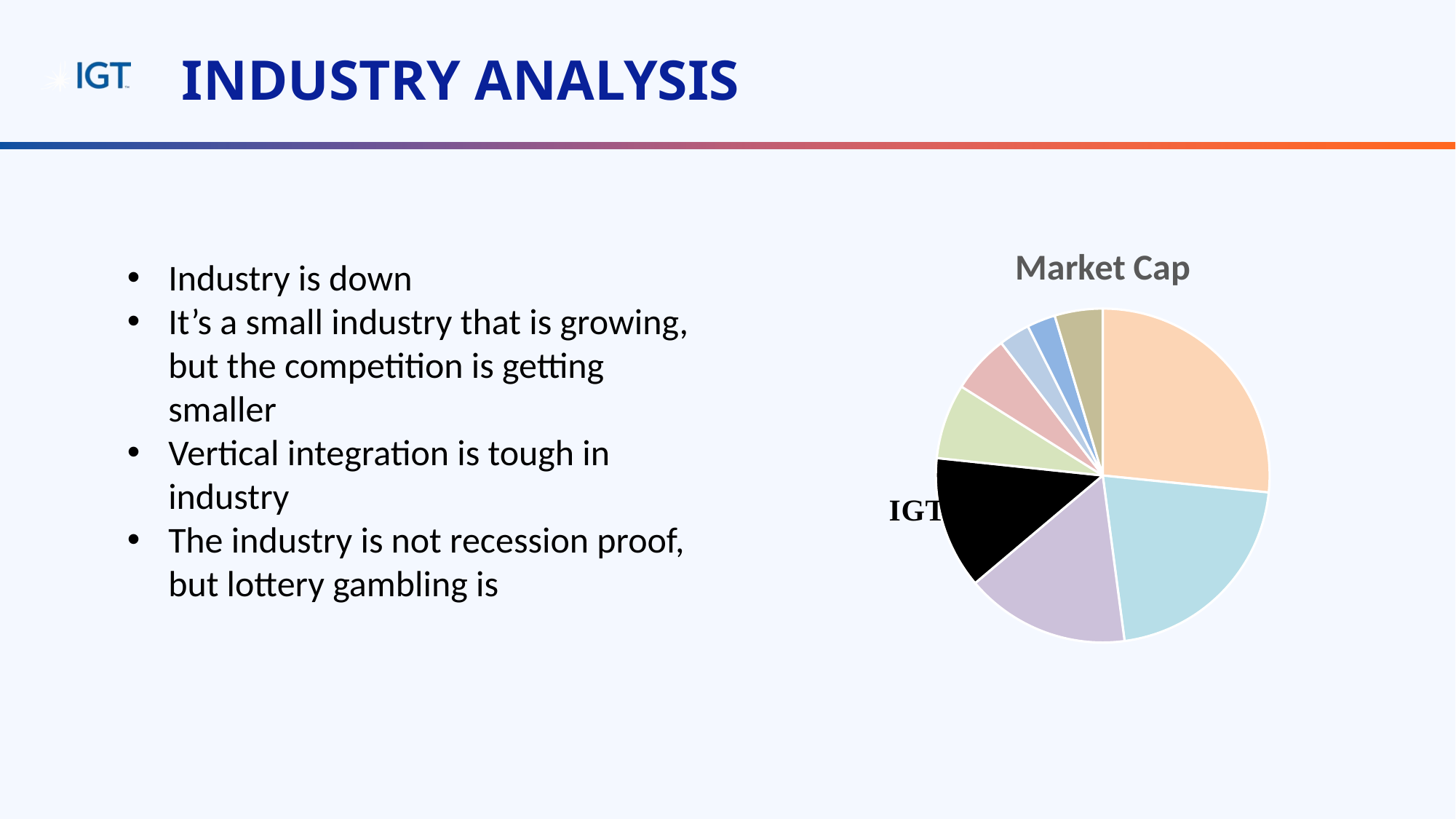
How many slices does the Market Cap pie chart have? 9 Is the IGT slice the largest slice of the Market Cap pie chart? No What is the title of the pie chart? Market Cap Does the largest slice of the Market Cap pie chart make up more or less than half of the pie? Less In the Market Cap pie chart, which is larger: the orange slice or the IGT slice? The orange slice Which slice of the Market Cap pie chart is labelled on the slide? IGT What kind of chart is shown on the slide? Pie chart In the Market Cap pie chart, which is larger: the IGT slice or the green slice? The IGT slice Does the IGT slice make up more or less than half of the Market Cap pie chart? Less